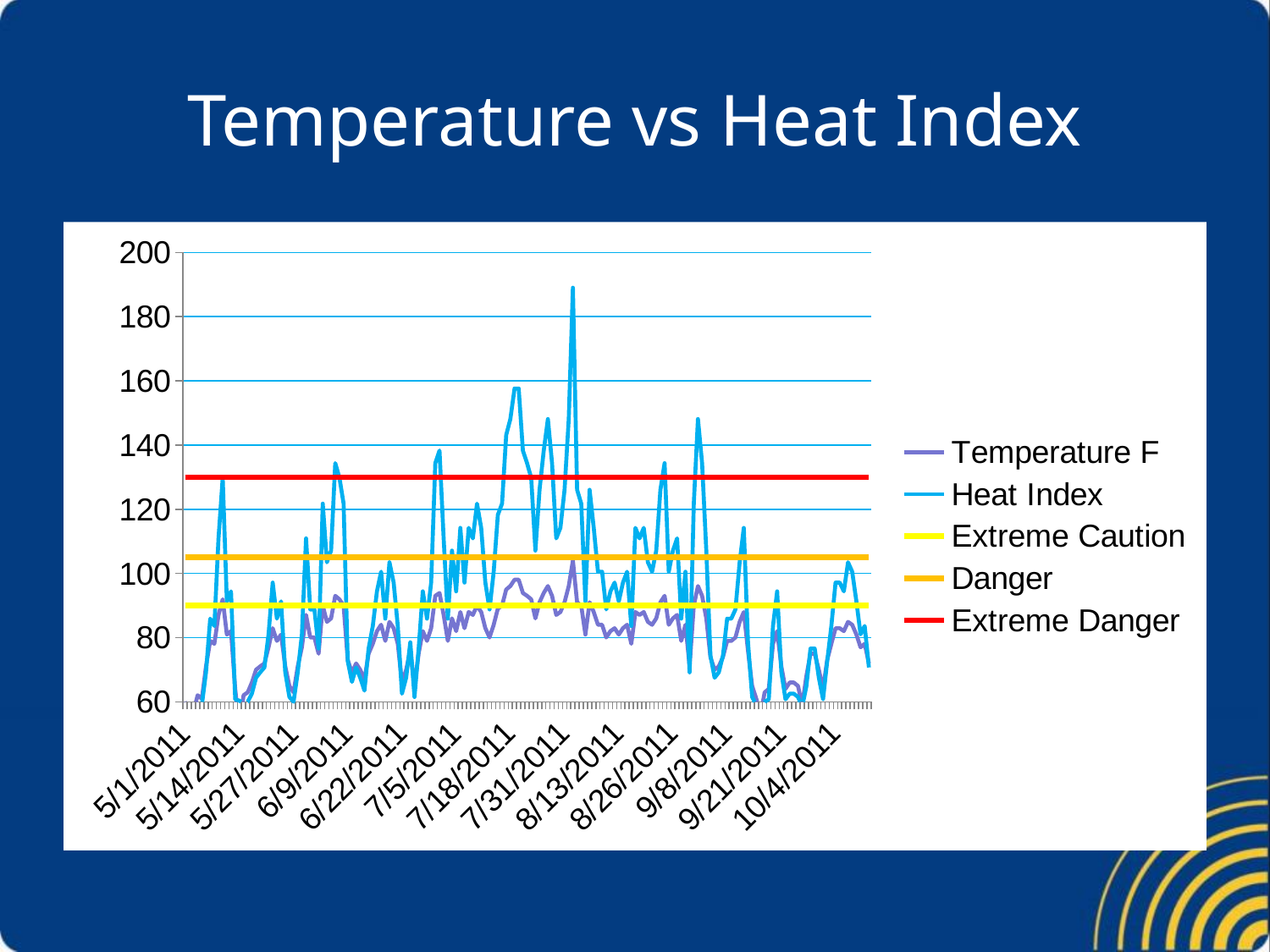
Which colour is used for the Extreme Danger line? Red Which series reaches the highest value on the chart, Temperature F or Heat Index? Heat Index Which of the three horizontal threshold lines is the highest? Extreme Danger Is the Extreme Caution line greater or less than 100? less Is the Danger line greater or less than 100? greater What is the title of the slide's chart? Temperature vs Heat Index Which of the three horizontal threshold lines is the lowest? Extreme Caution Is the highest peak of the Heat Index series greater or less than 180? greater What kind of chart is shown on the slide? Line chart How many series does the legend list? 5